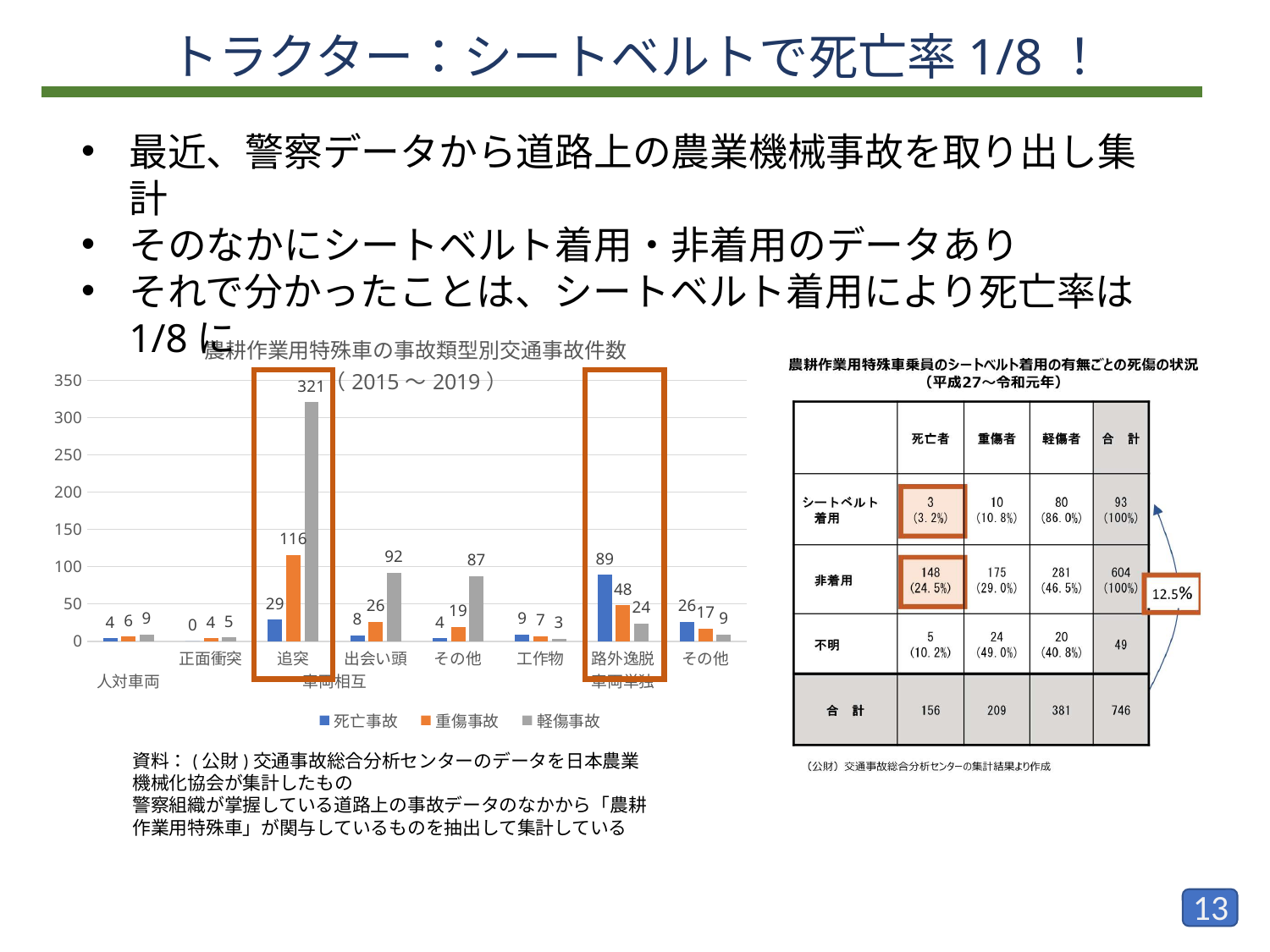
Which category has the highest 死亡事故 value? 路外逸脱 Which category has the highest 軽傷事故 value? 追突 Which is larger: the 死亡事故 value for 追突 or the 死亡事故 value for 路外逸脱? 路外逸脱 What is the value of 死亡事故 for 路外逸脱? 89 How many series does the chart legend list? 3 What is the value of 重傷事故 for 出会い頭? 26 Is the 軽傷事故 value for 追突 greater or less than 300? greater What kind of chart is shown on the slide? bar chart What is the value of 死亡事故 for 正面衝突? 0 What is the value of 軽傷事故 for 追突? 321 What is the title of the chart? 農耕作業用特殊車の事故類型別交通事故件数（2015～2019） What is the difference between the 重傷事故 value for 追突 and the 重傷事故 value for 路外逸脱? 68